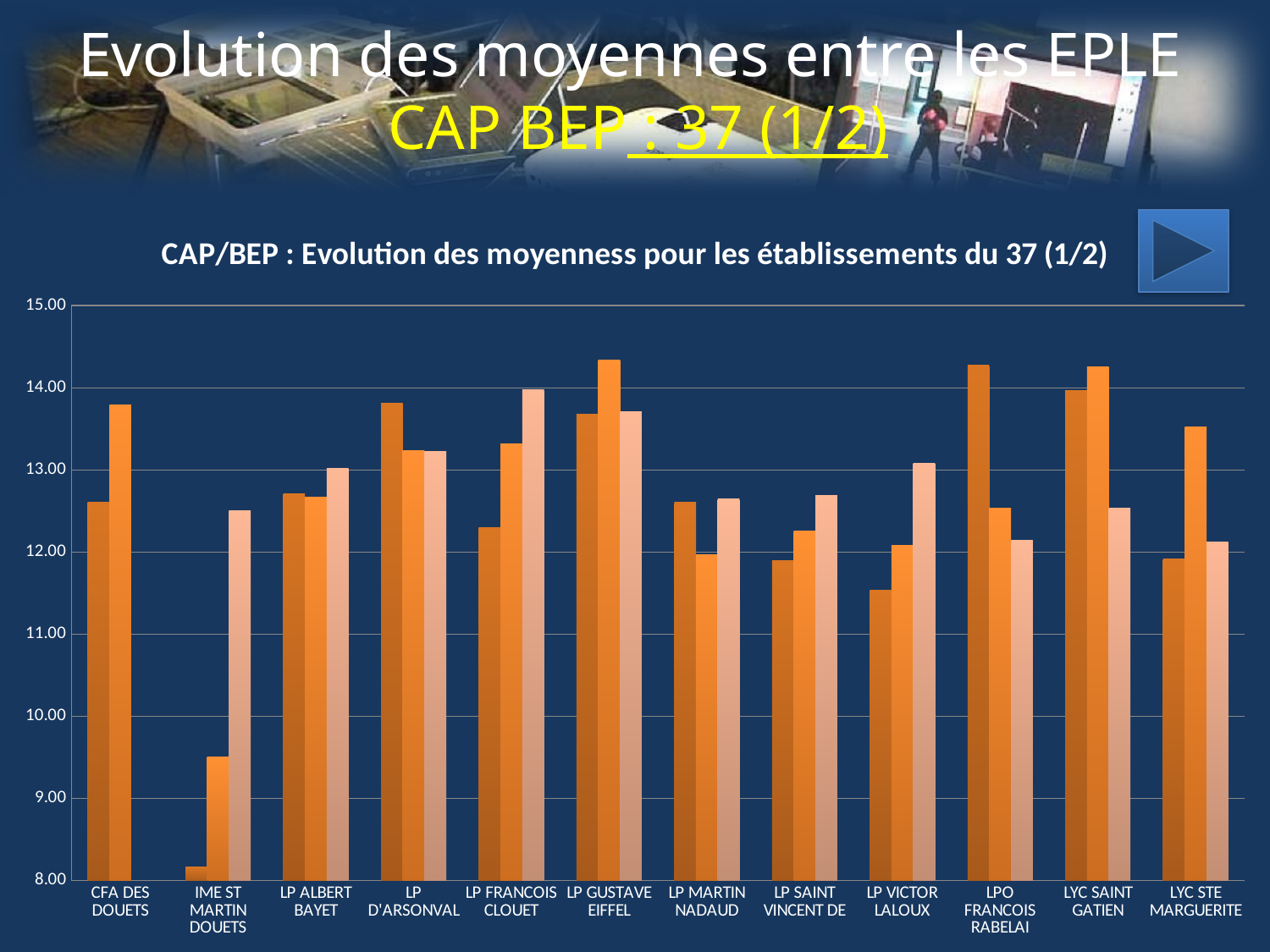
What kind of chart is shown on the slide? bar chart Is the leftmost bar for LPO FRANCOIS RABELAI greater or less than 14.00? greater Is the middle bar for LYC STE MARGUERITE greater or less than 13.00? greater How many establishments (categories) are shown on the x axis of the chart? 12 Is the leftmost bar for LP VICTOR LALOUX greater or less than 12.00? less Which establishment has the lowest bar in the chart? IME ST MARTIN DOUETS What is the title of the chart? CAP/BEP : Evolution des moyenness pour les établissements du 37 (1/2) Which is larger: the rightmost bar for LP VICTOR LALOUX or the rightmost bar for LP MARTIN NADAUD? LP VICTOR LALOUX Which is larger: the leftmost bar for IME ST MARTIN DOUETS or the leftmost bar for LP ALBERT BAYET? LP ALBERT BAYET What is the lowest value shown on the vertical axis of the chart? 8.00